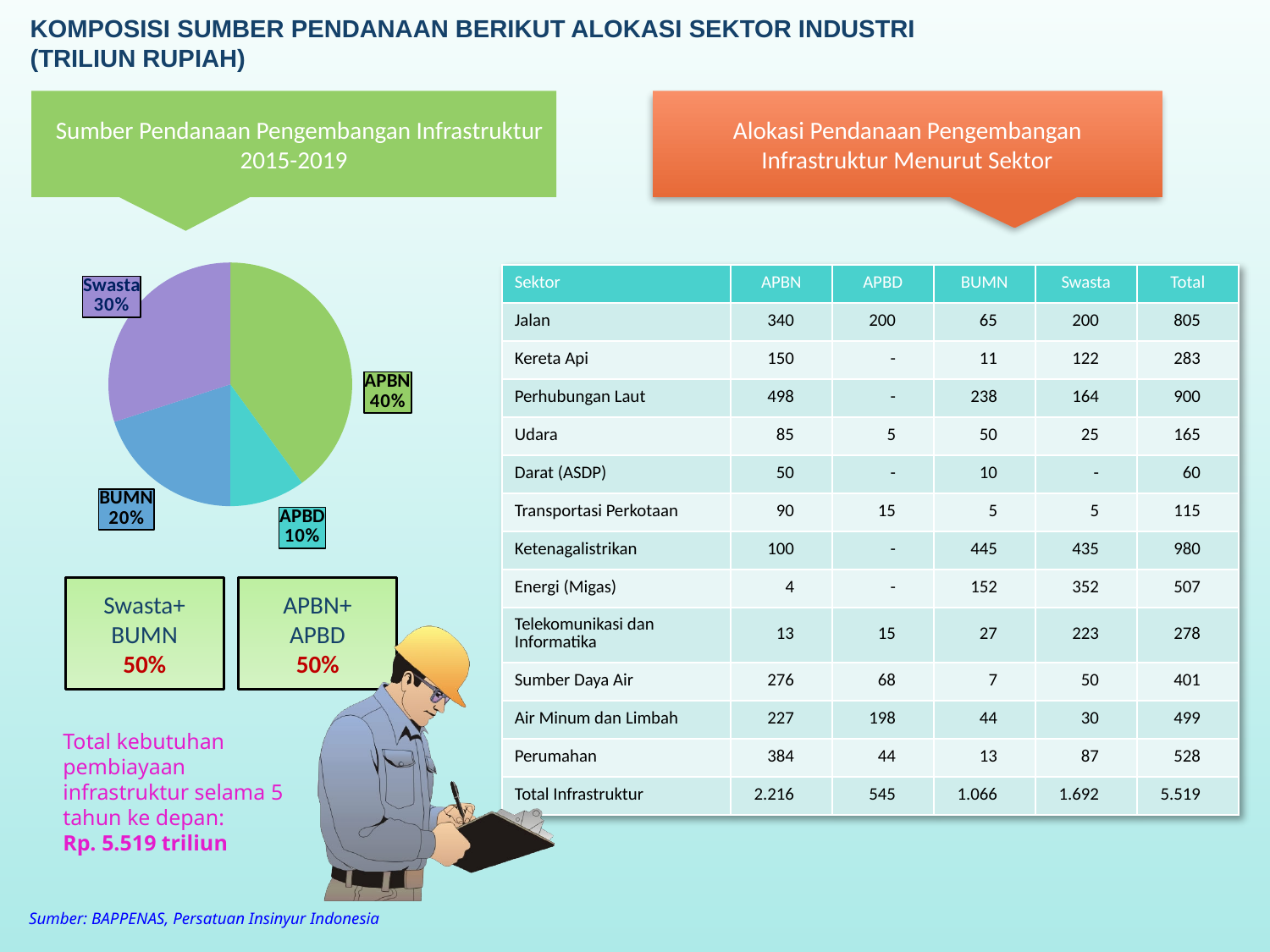
Which slice of the pie chart is the largest? APBN In the pie chart, what is the difference between the APBN share and the BUMN share? 20% In the pie chart, what share does BUMN have? 20% In the pie chart, what share does APBD have? 10% Which slice of the pie chart is the smallest? APBD In the pie chart, what share does APBN have? 40% In the pie chart, what is the combined share of Swasta and BUMN? 50% In the pie chart, what share does Swasta have? 30% How many slices does the pie chart have? 4 What colour is the APBN slice in the pie chart? green What kind of chart is shown on the left of the slide? pie chart In the pie chart, which is larger, the Swasta share or the BUMN share? Swasta